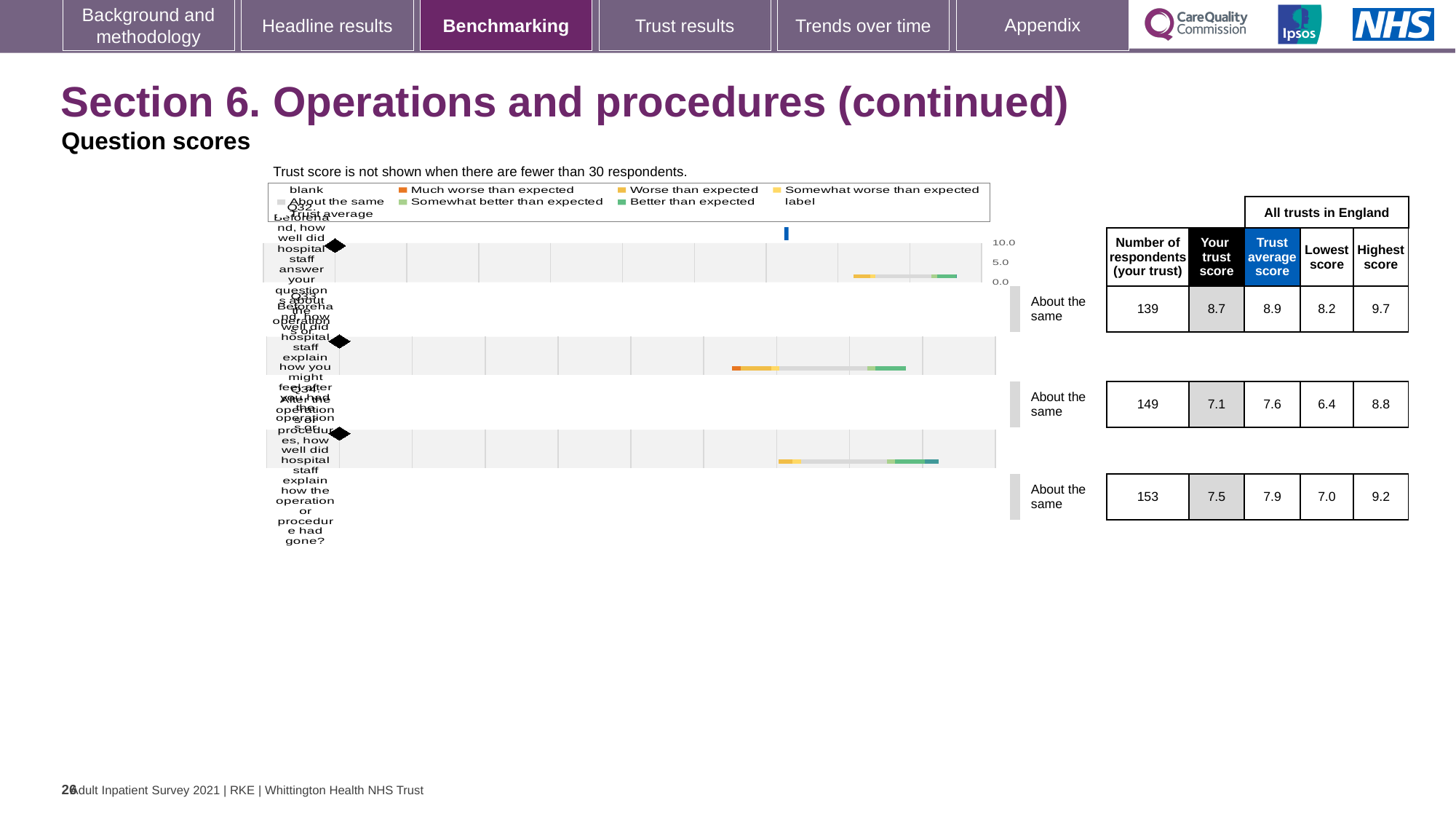
Which question has the lowest 'Your trust score'? Q33 What benchmark category is shown next to Q34? About the same What kind of chart is used to show the question scores? bar chart Which question has the highest 'Your trust score'? Q32 What is the 'Your trust score' for Q33 (how well staff explained how you might feel after the operation)? 7.1 What is the trust average score for Q34 (how well staff explained how the operation or procedure had gone)? 7.9 What is the difference between the trust average score and your trust score for Q33? 0.5 How many questions are plotted on the chart? 3 What is the lowest score across all trusts in England for Q33? 6.4 What is the highest score across all trusts in England for Q32? 9.7 Is your trust score for Q32 higher or lower than the trust average score? lower How many respondents (your trust) are shown for Q32 (how well staff answered questions about the operation or procedure)? 139